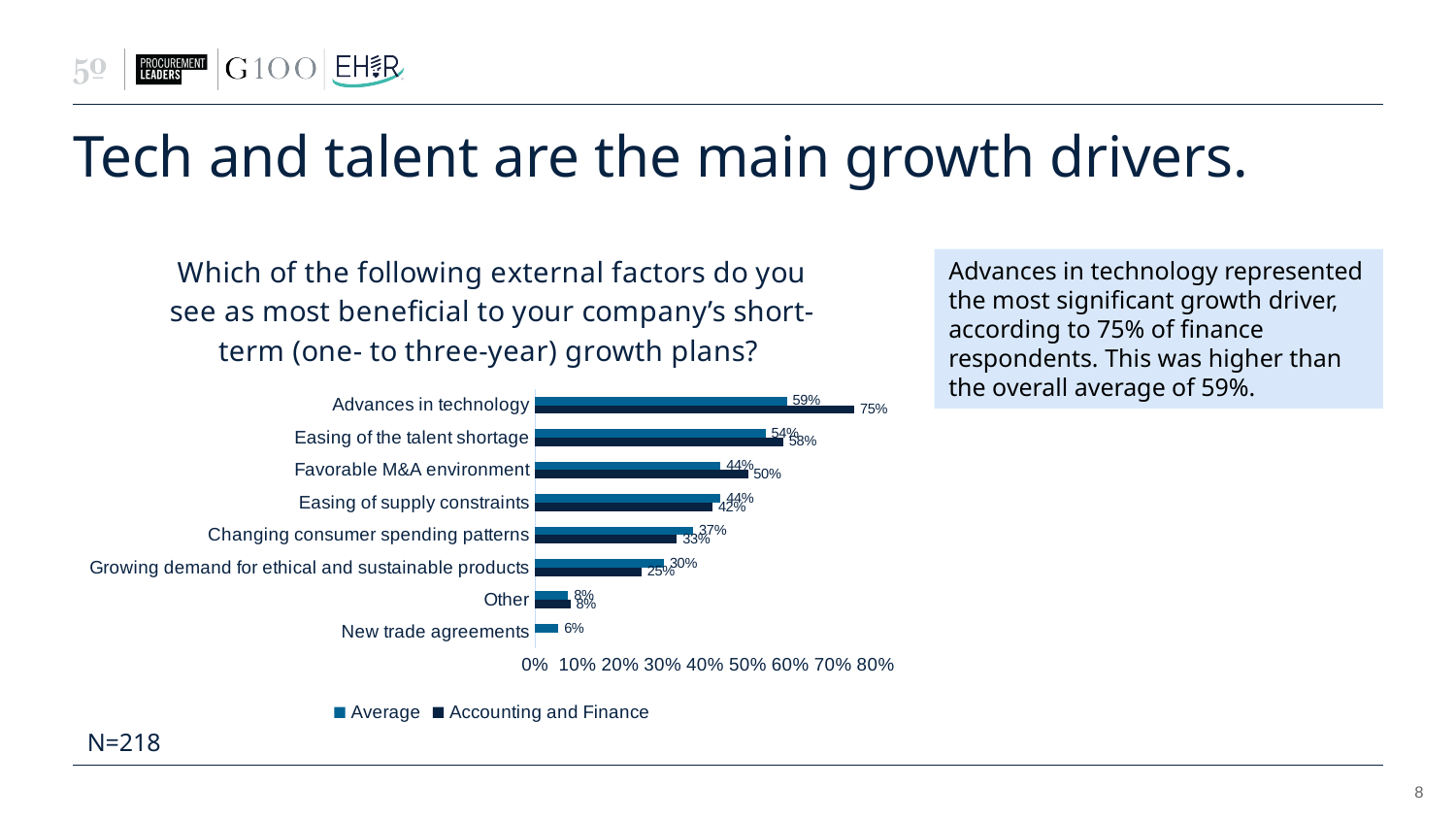
What is the Average value for Easing of the talent shortage? 54% What is the Accounting and Finance value for Favorable M&A environment? 50% What kind of chart is shown on the slide? Bar chart What is the difference between the Accounting and Finance value and the Average value for Advances in technology? 16% Which category has the lowest Average value? New trade agreements What is the Accounting and Finance value for Advances in technology? 75% How many categories are shown on the chart? 8 What is the Average value for Growing demand for ethical and sustainable products? 30% For Changing consumer spending patterns, which is larger: the Average value or the Accounting and Finance value? Average Which category has the highest Accounting and Finance value? Advances in technology What are the two series named in the chart legend? Average and Accounting and Finance How many series does the legend list? 2